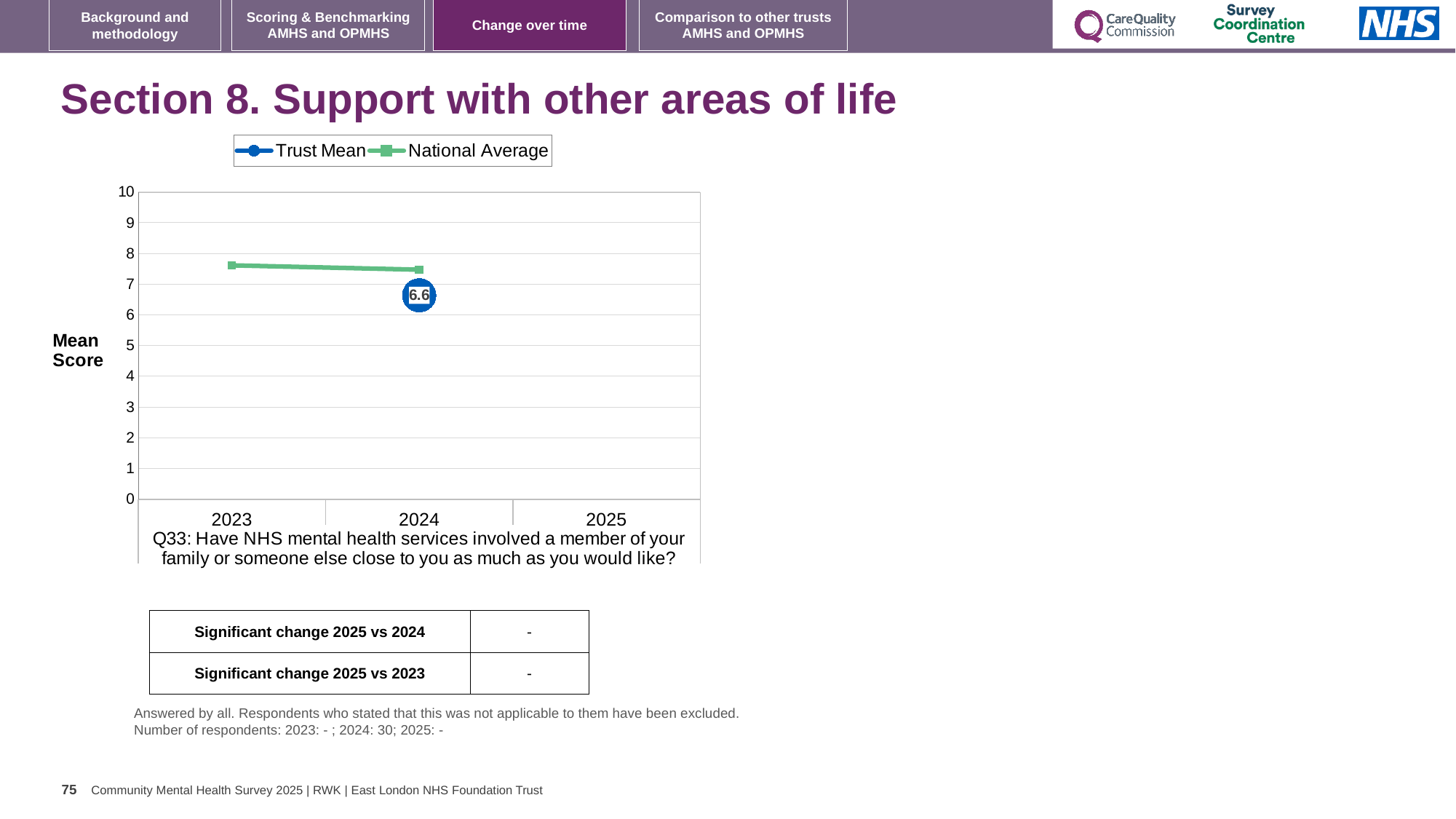
What is the label on the y axis? Mean Score In 2024, which is higher: the Trust Mean or the National Average? National Average Is the National Average value for 2023 greater or less than 7? greater How many years are shown on the x axis? 3 Is the Trust Mean value for 2024 greater or less than 7? less Is the National Average value for 2023 greater or less than 8? less How many series does the legend list? 2 Does the National Average rise or fall from 2023 to 2024? fall For which year is a Trust Mean value plotted? 2024 What kind of chart is shown on the slide? line chart What is the Trust Mean value for 2024? 6.6